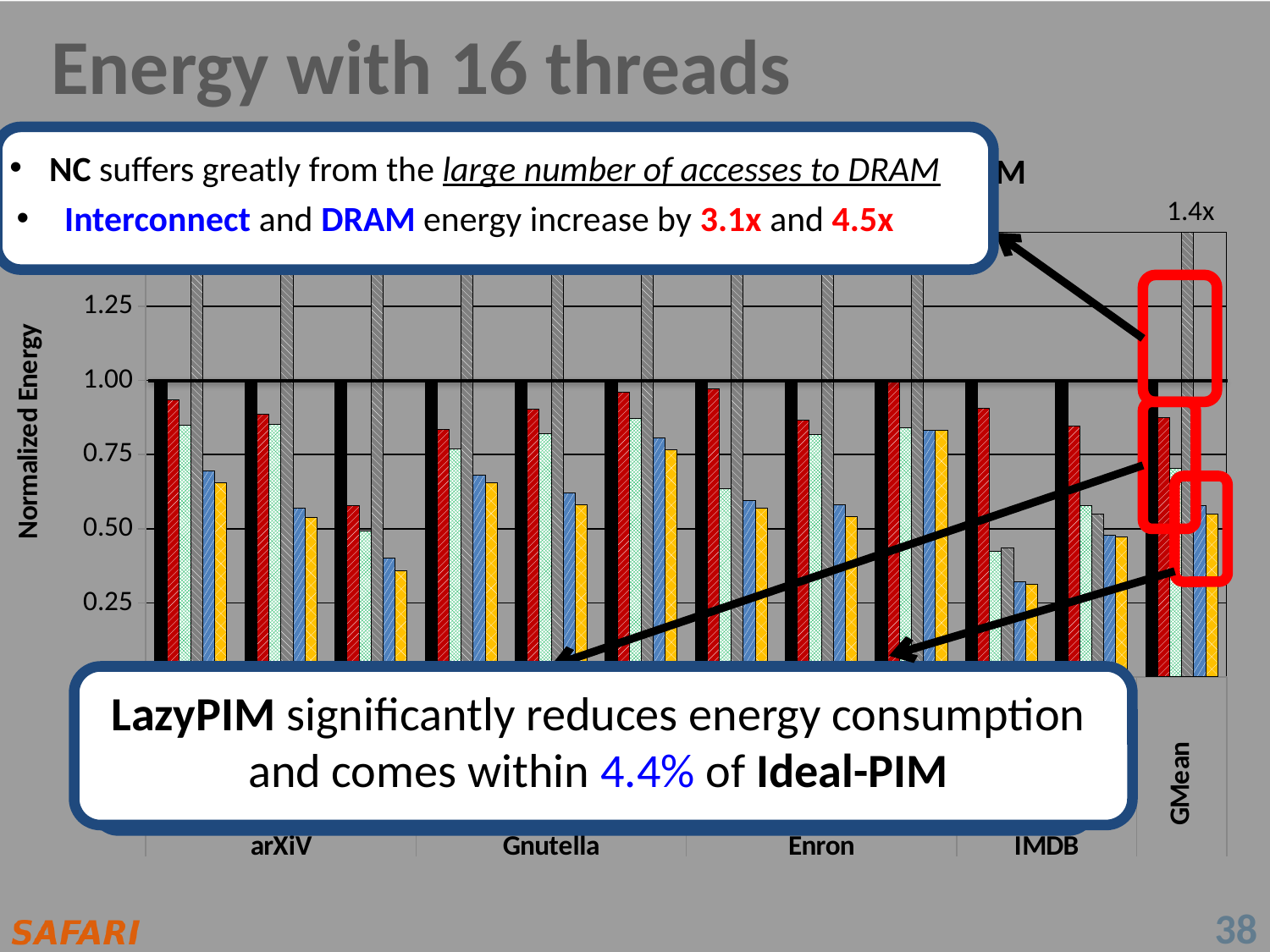
What kind of chart is shown on the slide? bar chart Is the value of the gray hatched bar in the GMean group greater or less than 1.00? greater What is the title of the chart on the slide? Energy with 16 threads Is the value of the red bar in the GMean group greater or less than 0.75? greater In the GMean group, which bar is taller: the red bar or the yellow bar? the red bar In the GMean group, which bar is taller: the black bar or the gray hatched bar? the gray hatched bar What is the label on the vertical axis of the chart? Normalized Energy What value is printed above the tallest gray hatched bar in the GMean group? 1.4x Is the value of the yellow bar in the GMean group greater or less than 0.75? less What is the rightmost category label on the x axis of the chart? GMean